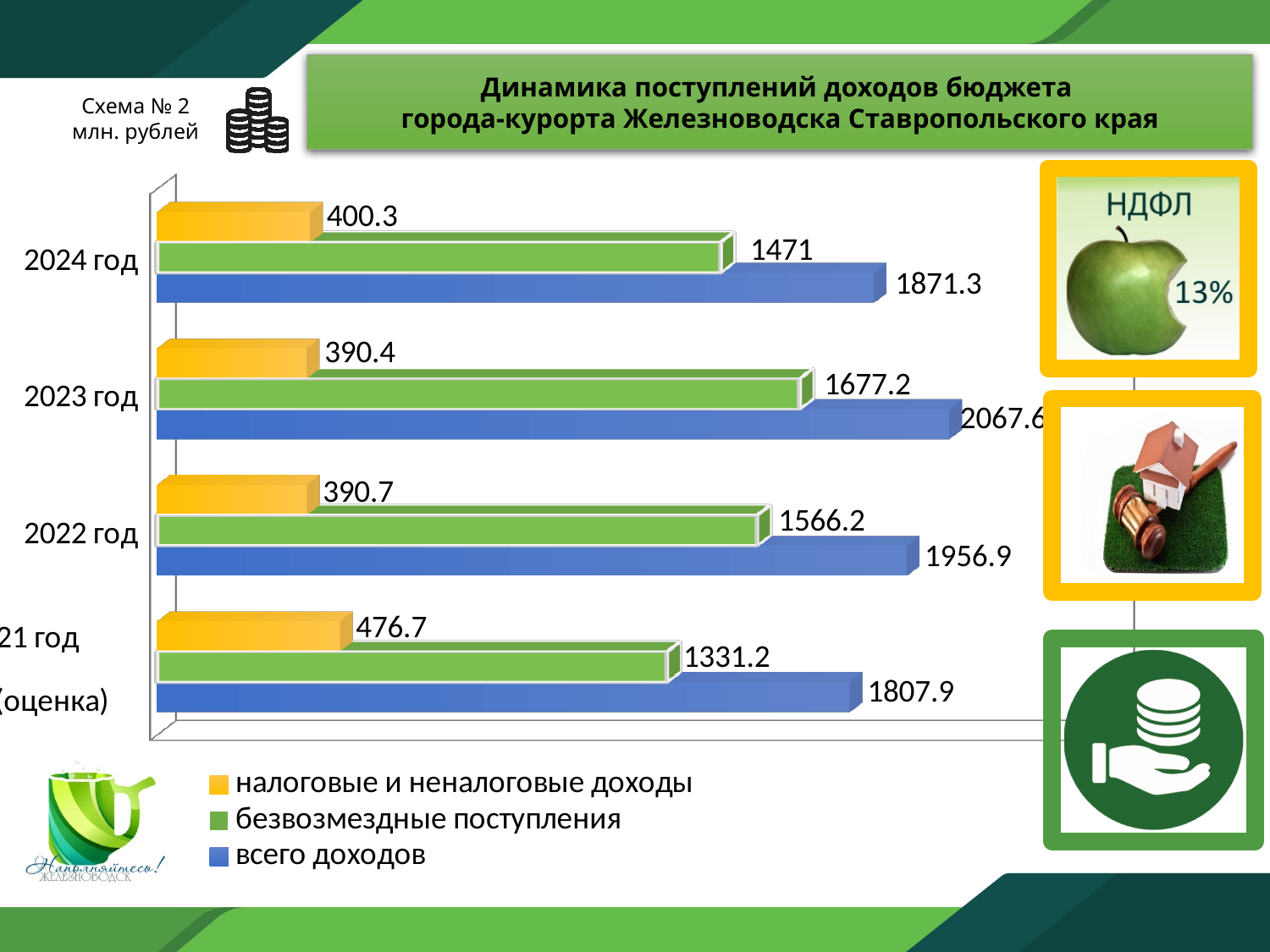
What kind of chart is shown on the slide? Bar chart What is the difference between всего доходов and безвозмездные поступления for 2024 год? 400.3 What is the value of налоговые и неналоговые доходы for 2022 год? 390.7 What is the value of всего доходов for 2024 год? 1871.3 Which is larger: безвозмездные поступления for 2022 год or for 2024 год? 2022 год Which year has the highest value of безвозмездные поступления? 2023 год What is the value of безвозмездные поступления for the bottom year group (2021 год, оценка)? 1331.2 How many series does the legend list? 3 What is the value of безвозмездные поступления for 2023 год? 1677.2 Which year has the highest value of всего доходов? 2023 год What colour represents всего доходов in the legend? Blue What is the difference between всего доходов and налоговые и неналоговые доходы for 2022 год? 1566.2